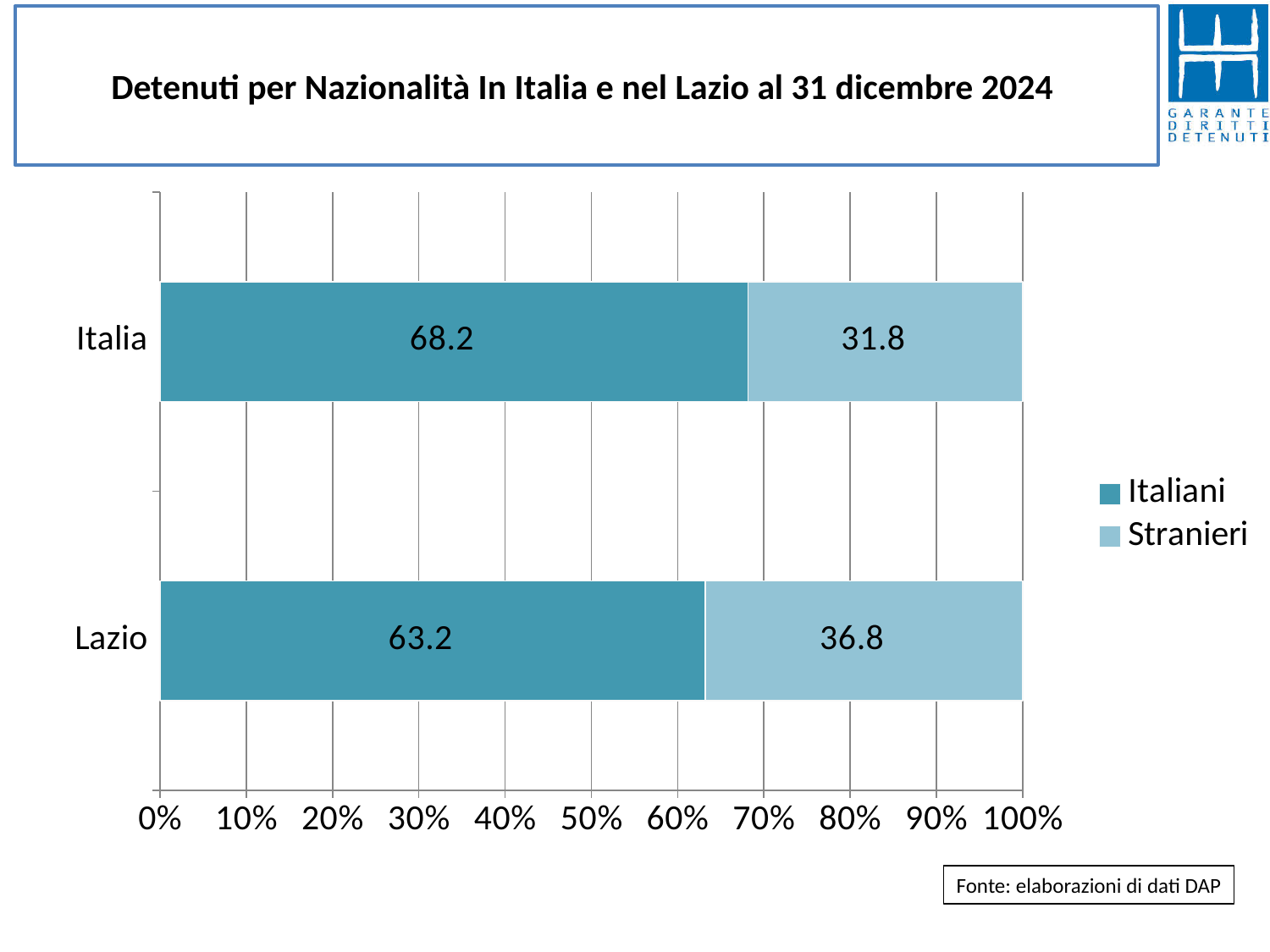
What kind of chart is shown on the slide? Stacked bar chart What is the difference between the Stranieri values for Lazio and Italia? 5.0 Which category has the higher Stranieri value, Italia or Lazio? Lazio What is the value for Stranieri in the Lazio bar? 36.8 How many series does the legend list? 2 What is the title of the chart? Detenuti per Nazionalità In Italia e nel Lazio al 31 dicembre 2024 What is the difference between the Italiani values for Italia and Lazio? 5.0 How many categories are shown on the chart? 2 What is the value for Stranieri in the Italia bar? 31.8 What is the value for Italiani in the Lazio bar? 63.2 Which category has the higher Italiani value, Italia or Lazio? Italia What is the value for Italiani in the Italia bar? 68.2